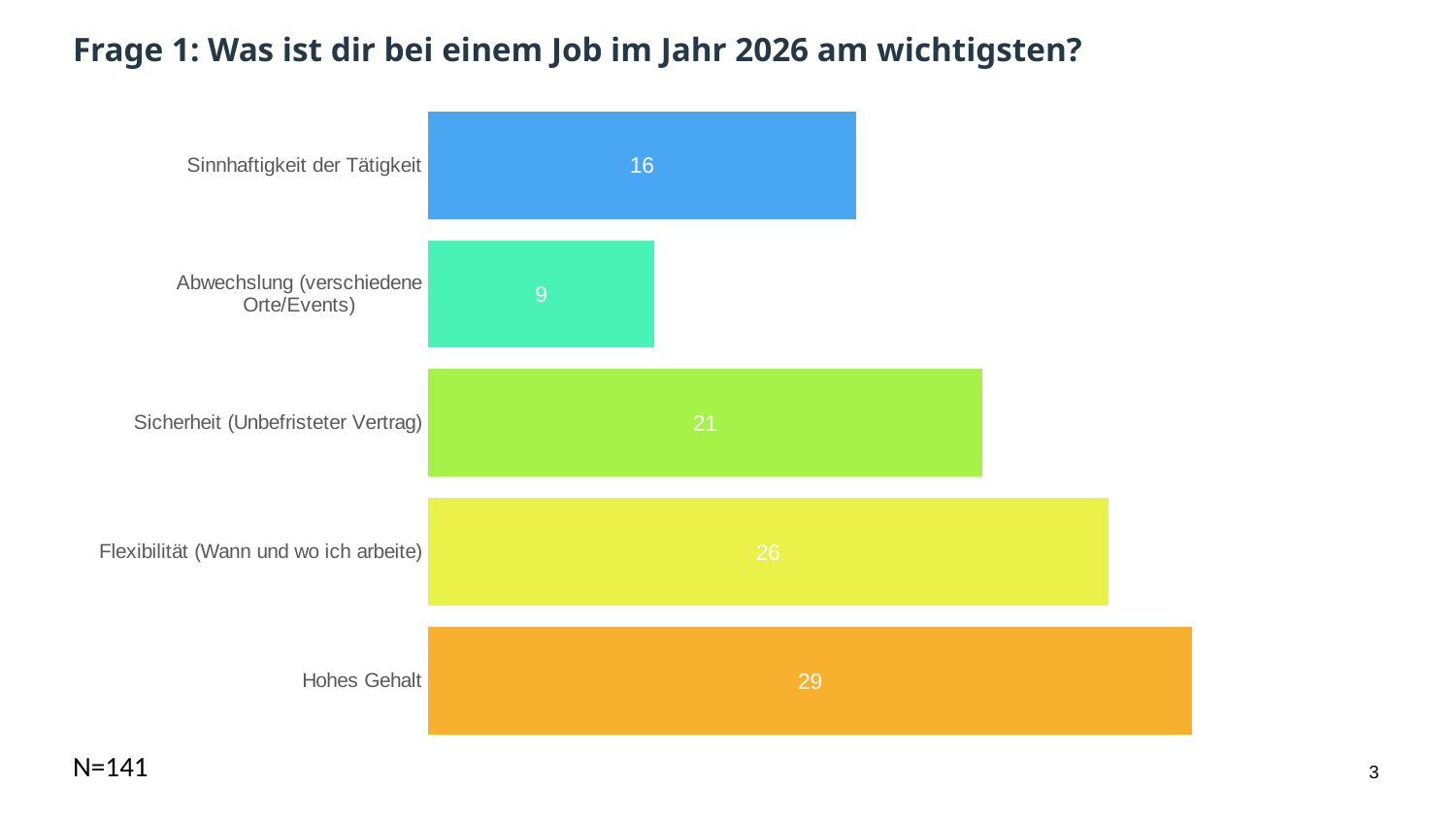
Which category has the lowest value? Abwechslung (verschiedene Orte/Events) How many categories are shown in the chart? 5 What is the value for Sicherheit (Unbefristeter Vertrag)? 21 What is the title of the slide? Frage 1: Was ist dir bei einem Job im Jahr 2026 am wichtigsten? What is the difference between the values for Hohes Gehalt and Flexibilität (Wann und wo ich arbeite)? 3 What kind of chart is shown on the slide? Bar chart Which category has the highest value? Hohes Gehalt What is the value for Abwechslung (verschiedene Orte/Events)? 9 Which is larger, the value for Flexibilität (Wann und wo ich arbeite) or the value for Sicherheit (Unbefristeter Vertrag)? Flexibilität (Wann und wo ich arbeite) What is the value for Hohes Gehalt? 29 What is the difference between the values for Sicherheit (Unbefristeter Vertrag) and Sinnhaftigkeit der Tätigkeit? 5 What is the value for Sinnhaftigkeit der Tätigkeit? 16